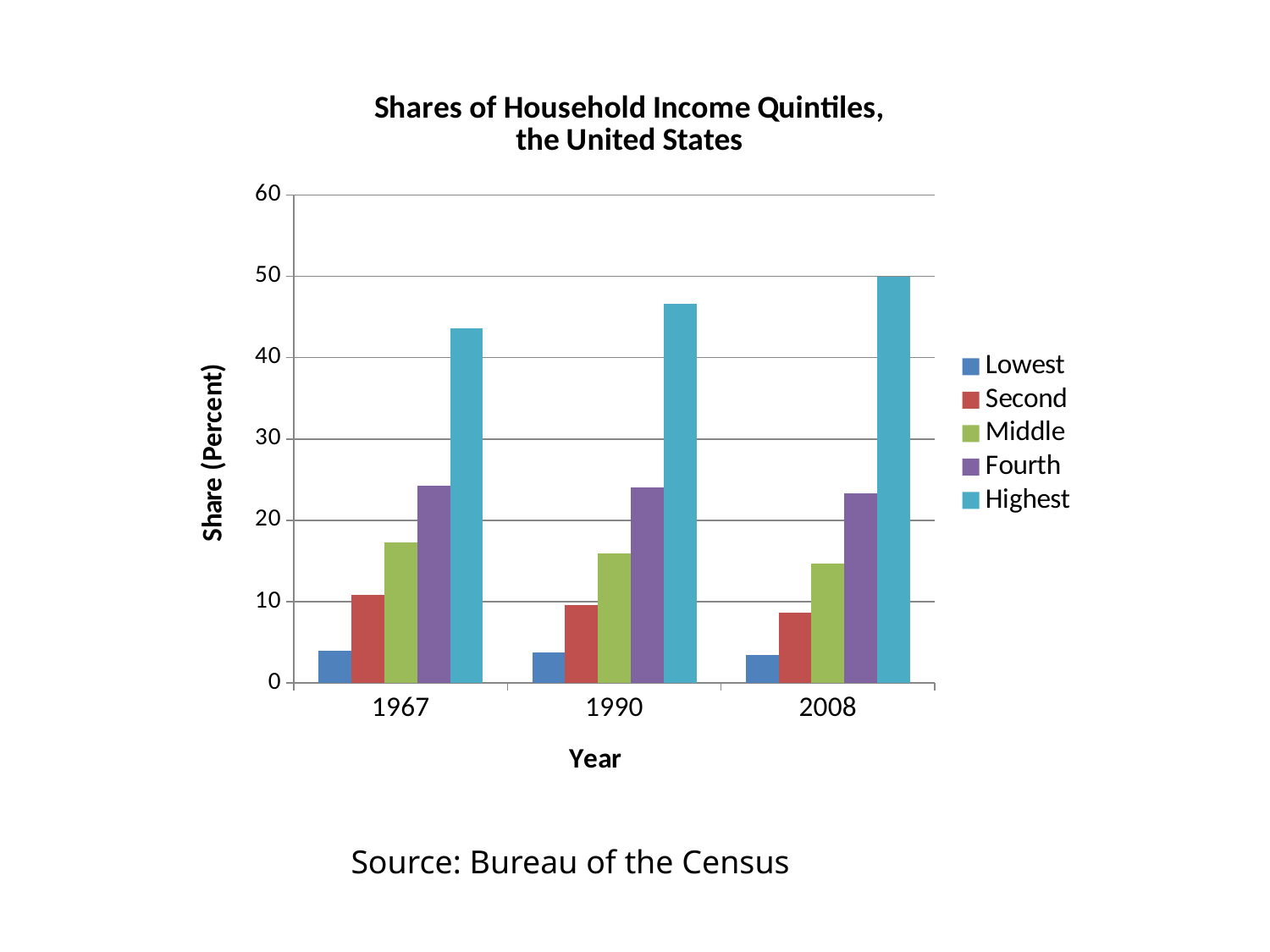
What kind of chart is shown on the slide? bar chart Does the share of the Highest quintile rise or fall from 1967 to 2008? rise Which quintile has the tallest bar in every year? Highest Which quintile has the shortest bar in every year? Lowest Which is larger: the Middle quintile's share in 1967 or in 2008? 1967 Does the share of the Middle quintile rise or fall from 1967 to 2008? fall How many series does the legend list? 5 Is the value for the Highest quintile in 1967 greater or less than 40? greater Is the value for the Middle quintile in 1967 greater or less than 20? less Is the value for the Second quintile in 2008 greater or less than 10? less How many years are shown on the x axis? 3